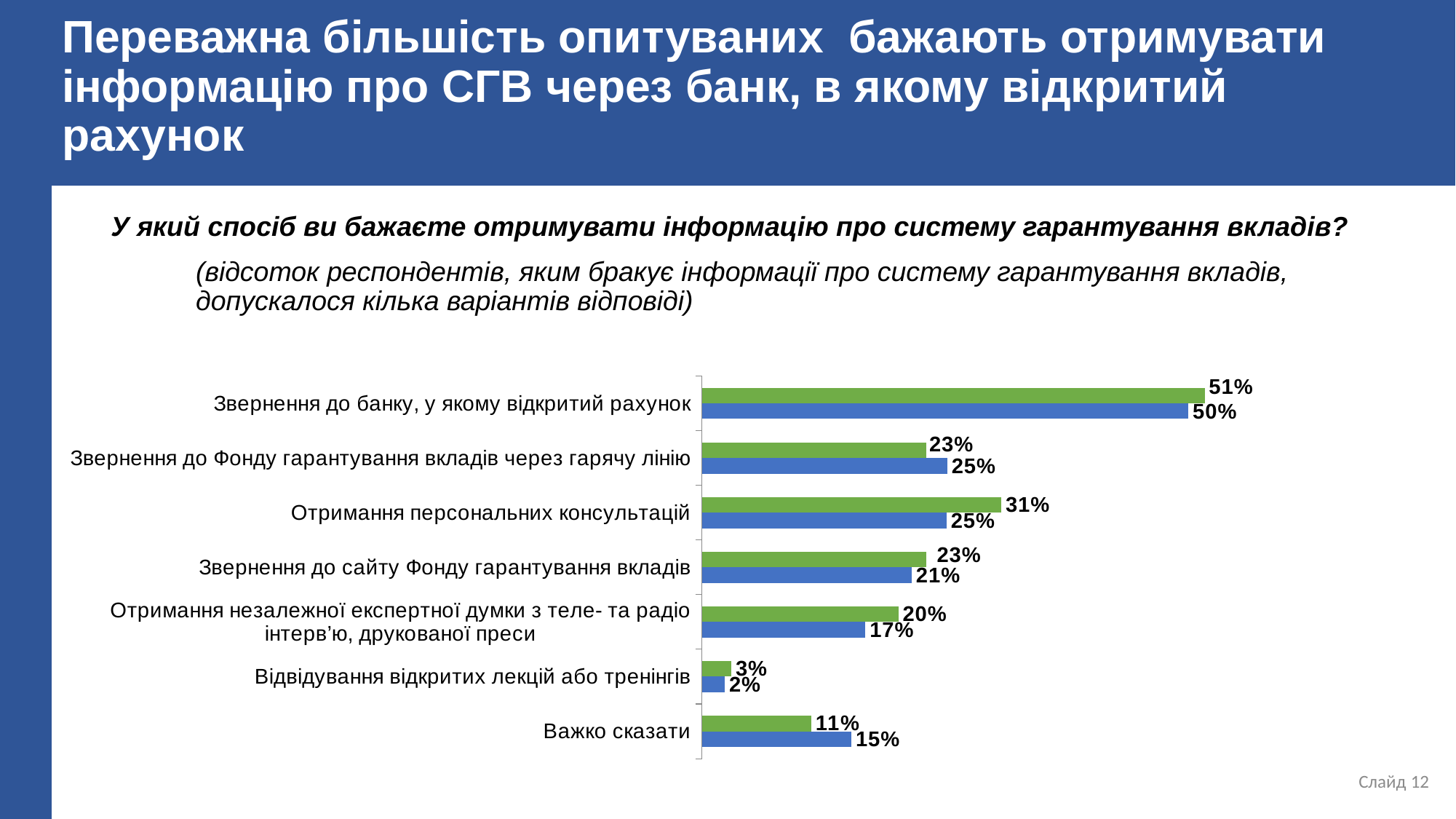
What type of chart is shown on the slide? bar chart Which category has the lowest value for the blue bars? Відвідування відкритих лекцій або тренінгів What is the value of the green bar for "Отримання персональних консультацій"? 31% What colours are the two series of bars in the chart? green and blue What is the value of the blue bar for "Важко сказати"? 15% What is the value of the green bar for "Звернення до банку, у якому відкритий рахунок"? 51% What is the difference between the green and blue bars for "Отримання персональних консультацій"? 6% How many categories are shown in the chart? 7 What is the difference between the green bar for "Отримання незалежної експертної думки з теле- та радіо інтерв'ю, друкованої преси" and its blue bar? 3% What is the value of the blue bar for "Звернення до банку, у якому відкритий рахунок"? 50% Which category has the highest value for the green bars? Звернення до банку, у якому відкритий рахунок For "Звернення до Фонду гарантування вкладів через гарячу лінію", which bar is larger, green or blue? blue